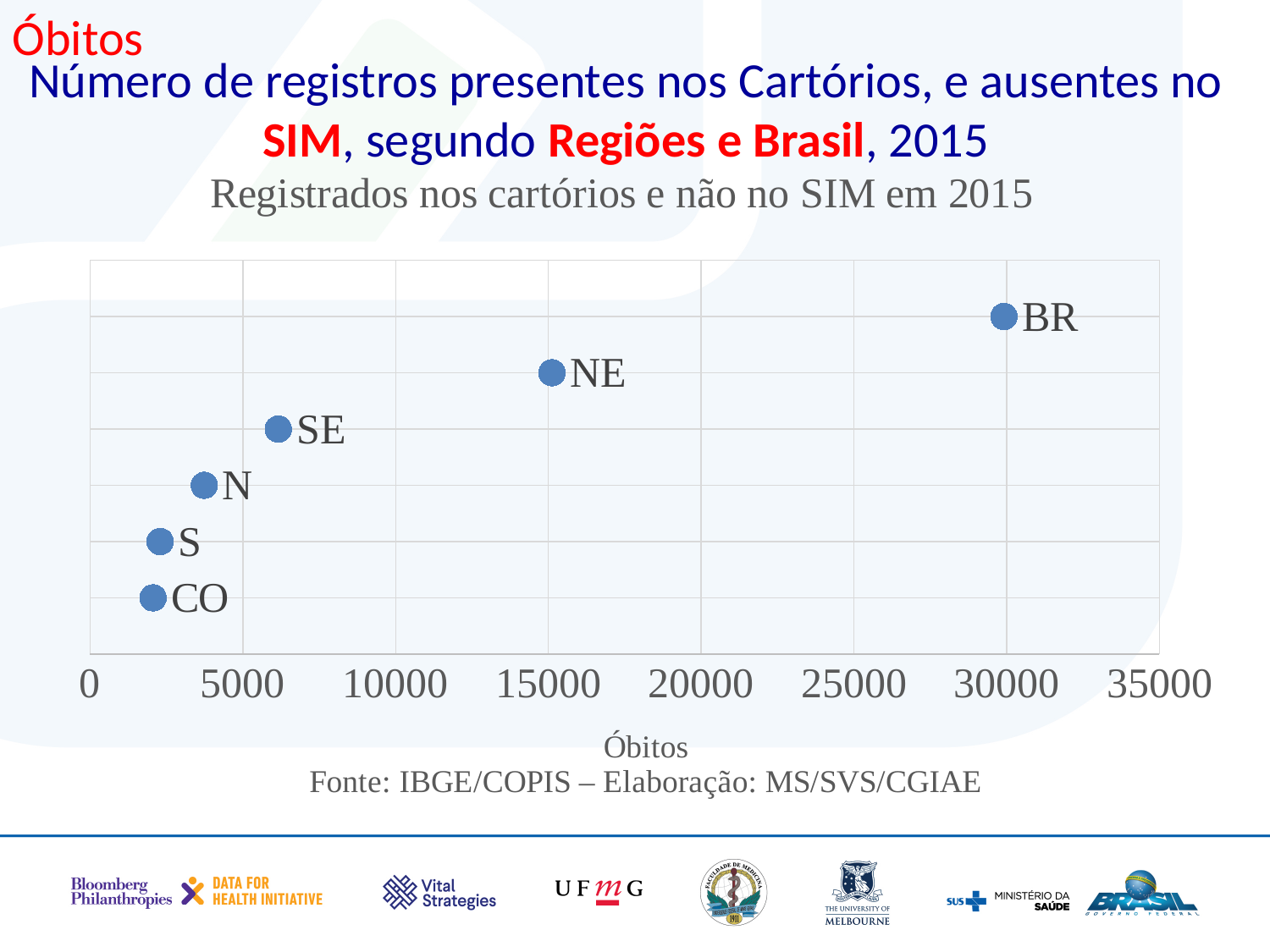
What kind of chart is shown on the slide? scatter chart Is the value for NE greater or less than 10000? greater Which has a larger value, NE or SE? NE Is the value for CO greater or less than 5000? less Which has a larger value, SE or N? SE How many data points are plotted in the chart? 6 Is the value for SE greater or less than 5000? greater Which point has the highest value on the Óbitos axis? BR What is the title of the horizontal axis of the chart? Óbitos